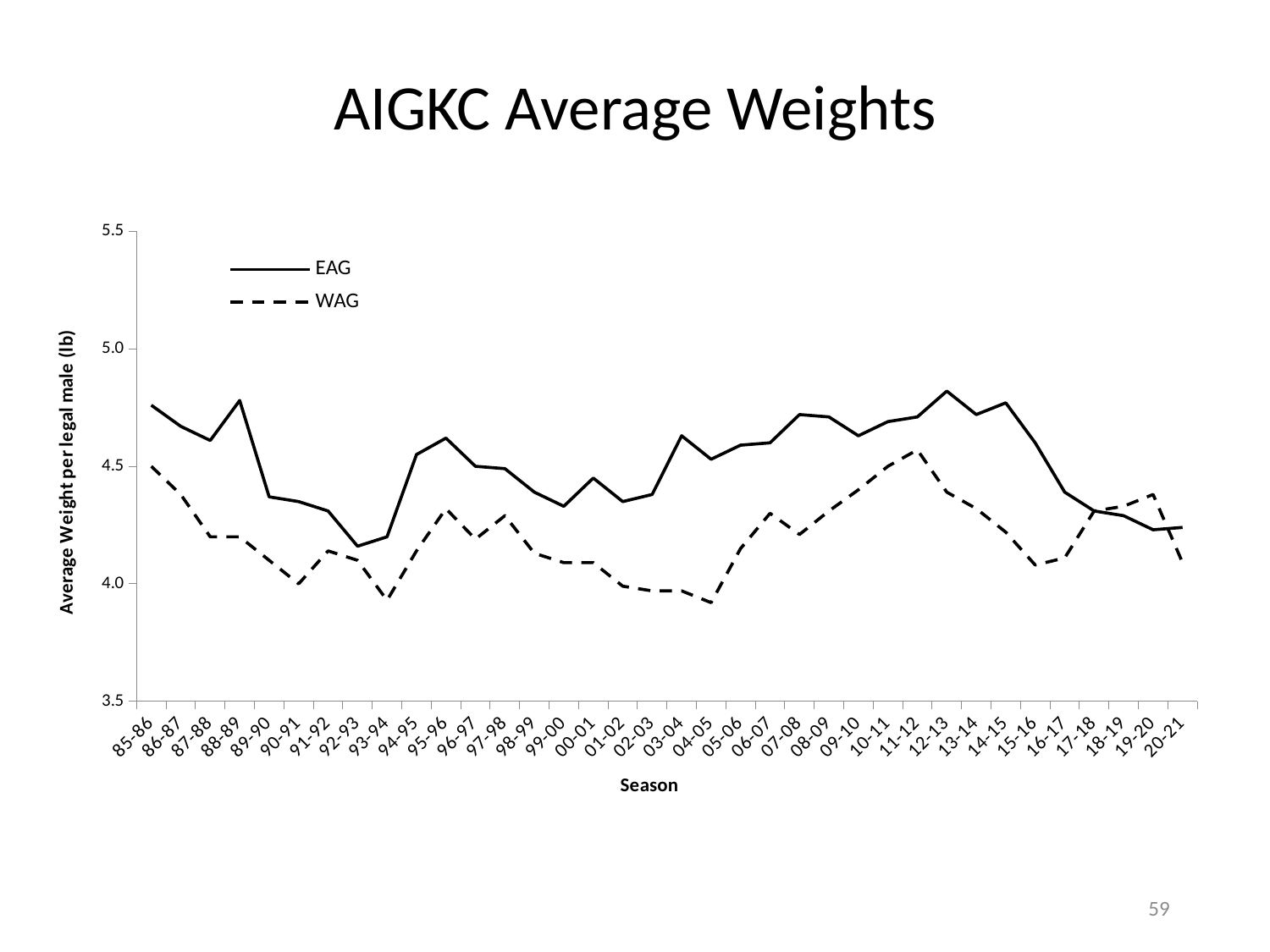
Is the EAG value for 12-13 greater or less than 4.5? greater Is the WAG value for 93-94 greater or less than 4.0? less What is the title of the chart? AIGKC Average Weights In the 85-86 season, which series has the higher average weight, EAG or WAG? EAG In the 19-20 season, which series has the higher average weight, EAG or WAG? WAG Is the WAG value for 04-05 greater or less than 4.0? less Does the EAG line rise or fall from 14-15 to 20-21? fall What kind of chart is shown on the slide? Line chart How many seasons are plotted along the x axis? 36 How many series does the legend list? 2